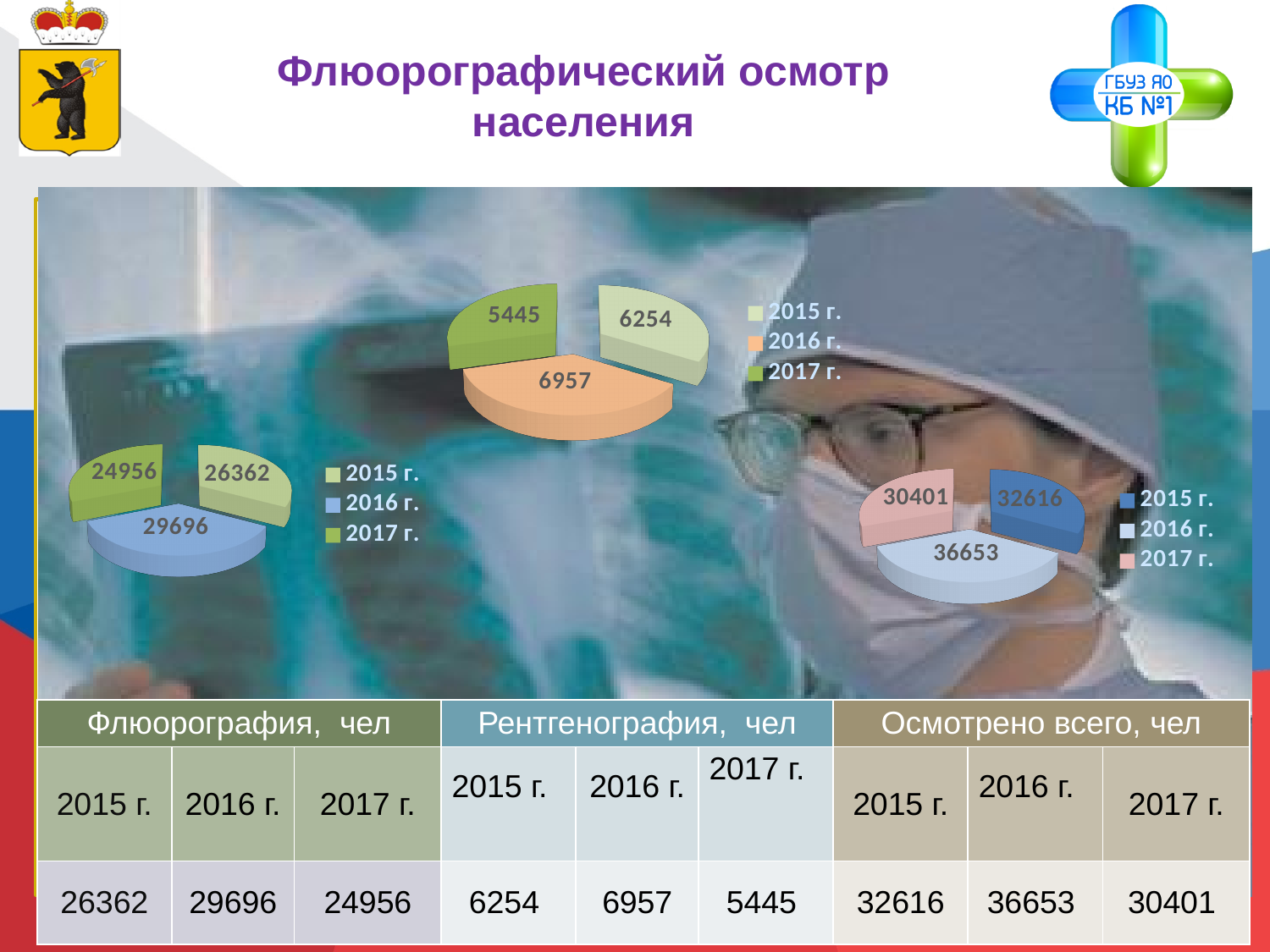
On the left pie chart, what is the difference between the values for 2016 г. and 2017 г.? 4740 How many slices does the top-centre pie chart have? 3 On the top-centre pie chart, what is the value for 2017 г.? 5445 On the right pie chart, what is the value for 2015 г.? 32616 On the left pie chart, which year has the smallest value? 2017 г. On the top-centre pie chart, which year has the smallest slice? 2017 г. On the top-centre pie chart, what is the difference between the values for 2016 г. and 2015 г.? 703 How many entries does the legend of the left pie chart list? 3 On the left pie chart, what is the value for 2016 г.? 29696 On the right pie chart, which year has the largest slice? 2016 г. On the right pie chart, which is larger: the value for 2015 г. or the value for 2017 г.? 2015 г. What type of chart is the right chart on the slide? Pie chart